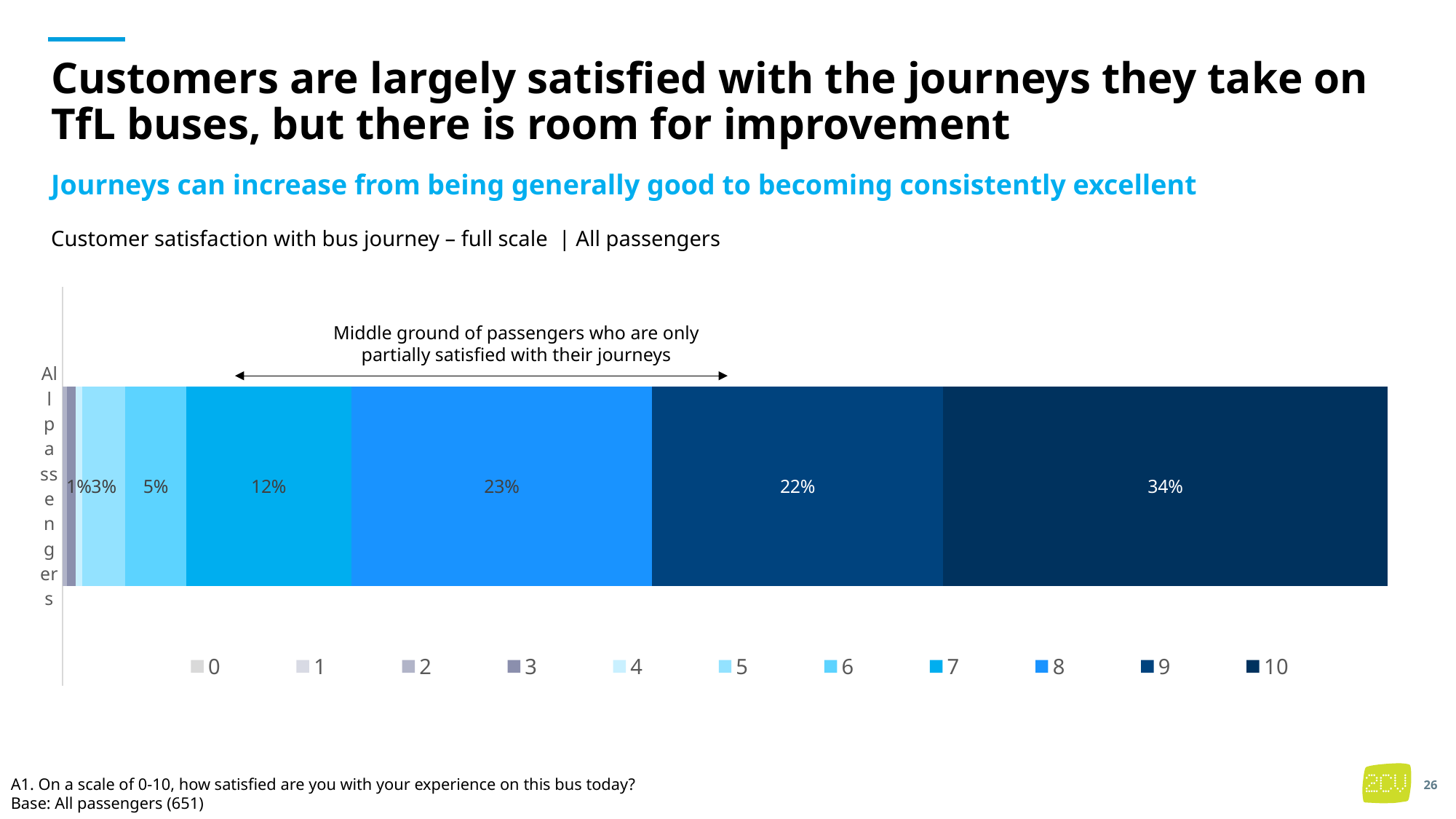
Which has the larger share of passengers: a score of 8 or a score of 9? 8 What percentage of passengers gave a satisfaction score of 8? 23% What percentage of passengers gave a satisfaction score of 10? 34% What percentage of passengers gave a satisfaction score of 7? 12% What does the annotation above the arrow in the chart describe? Middle ground of passengers who are only partially satisfied with their journeys What is the difference between the share of passengers scoring 10 and the share scoring 9? 12% Which satisfaction score has the largest share of passengers? 10 What is the combined share of passengers who scored 9 or 10? 56% How many categories (bars) are plotted in the chart? 1 How many series does the legend list? 11 What kind of chart is shown on the slide? Stacked bar chart What percentage of passengers gave a satisfaction score of 9? 22%